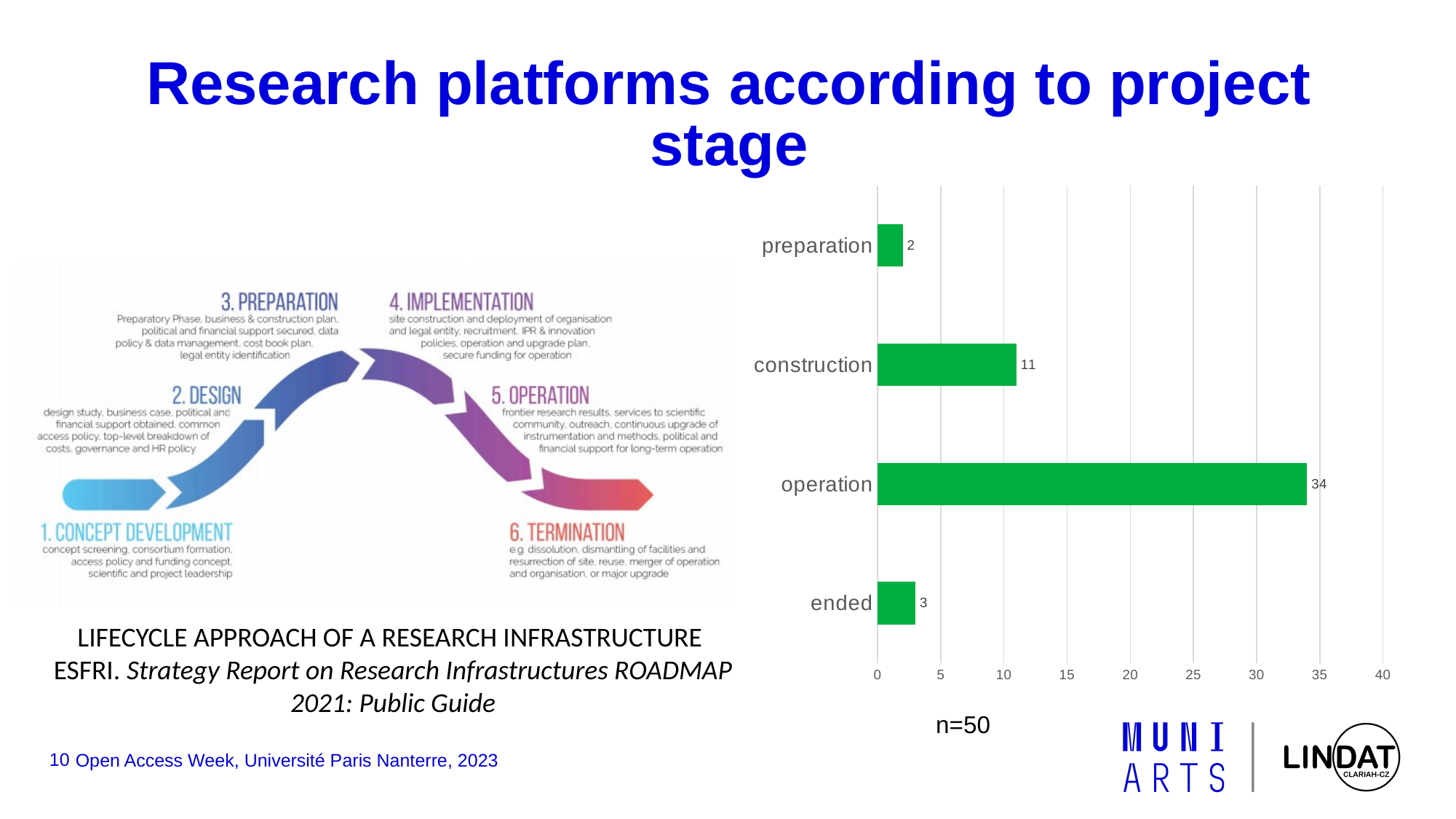
What is the value for ended? 3 What sample size is stated below the chart? n=50 What is the value for preparation? 2 Is the value for operation greater or less than 30? greater What kind of chart is shown on the right of the slide? bar chart What is the value for operation? 34 Which category has the lowest value? preparation What is the difference between the values for operation and construction? 23 How many categories are shown in the bar chart? 4 What is the value for construction? 11 Which category has the highest value? operation Which is larger, the value for ended or the value for preparation? ended